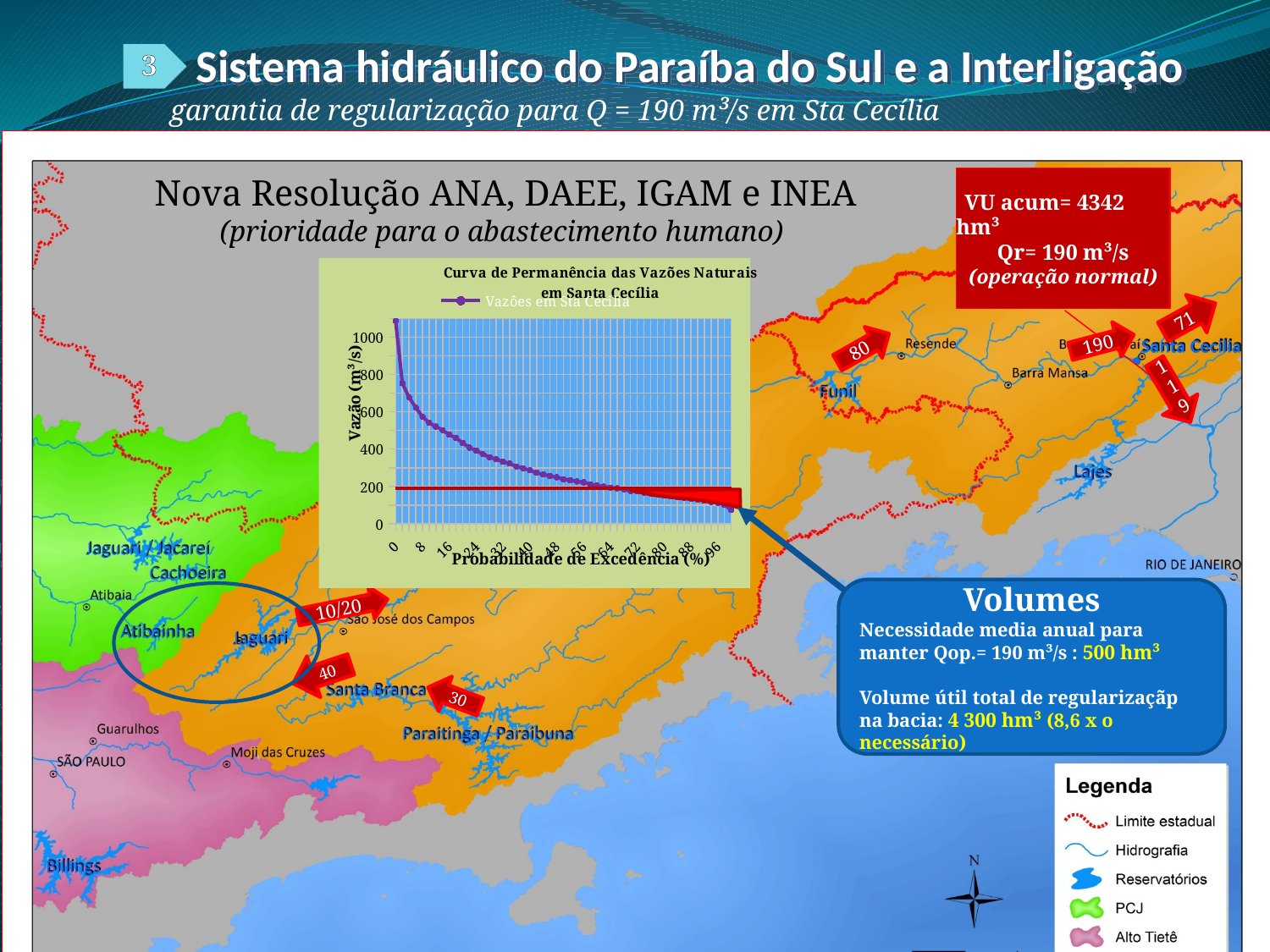
How many series does the chart legend list? 1 Is the value at 48% probability of exceedance greater or less than 400? less Is the value at 24% probability of exceedance greater or less than 600? less At which probability of exceedance is the plotted flow highest? 0 What kind of chart is shown on the slide? line chart What is the title of the chart on the slide? Curva de Permanência das Vazões Naturais em Santa Cecília Is the value at 96% probability of exceedance greater or less than 200? less What is the name of the series shown in the chart legend? Vazões em Sta Cecília Do the plotted values rise or fall as the probability of exceedance increases along the x axis? fall